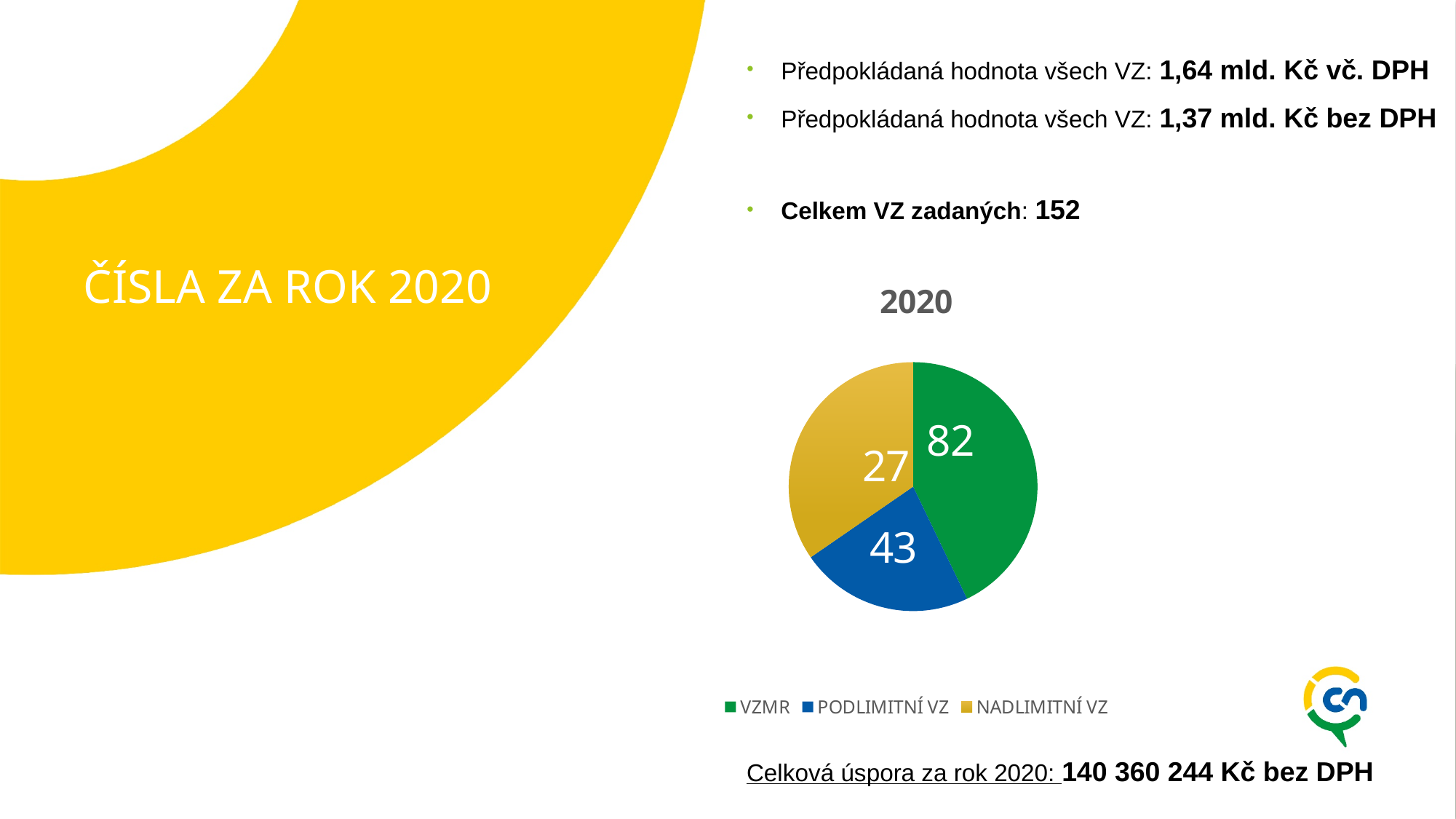
What is the chart's title? 2020 What is the value for PODLIMITNÍ VZ in the pie chart? 43 What is the difference between the values for VZMR and PODLIMITNÍ VZ? 39 Which category has the largest slice of the pie? VZMR How many slices does the pie chart have? 3 What type of chart is shown on the slide? pie chart Which is larger, the value for PODLIMITNÍ VZ or the value for NADLIMITNÍ VZ? PODLIMITNÍ VZ What is the value for NADLIMITNÍ VZ in the pie chart? 27 What colour is the VZMR slice in the pie chart? green What is the value for VZMR in the pie chart? 82 What is the difference between the values for PODLIMITNÍ VZ and NADLIMITNÍ VZ? 16